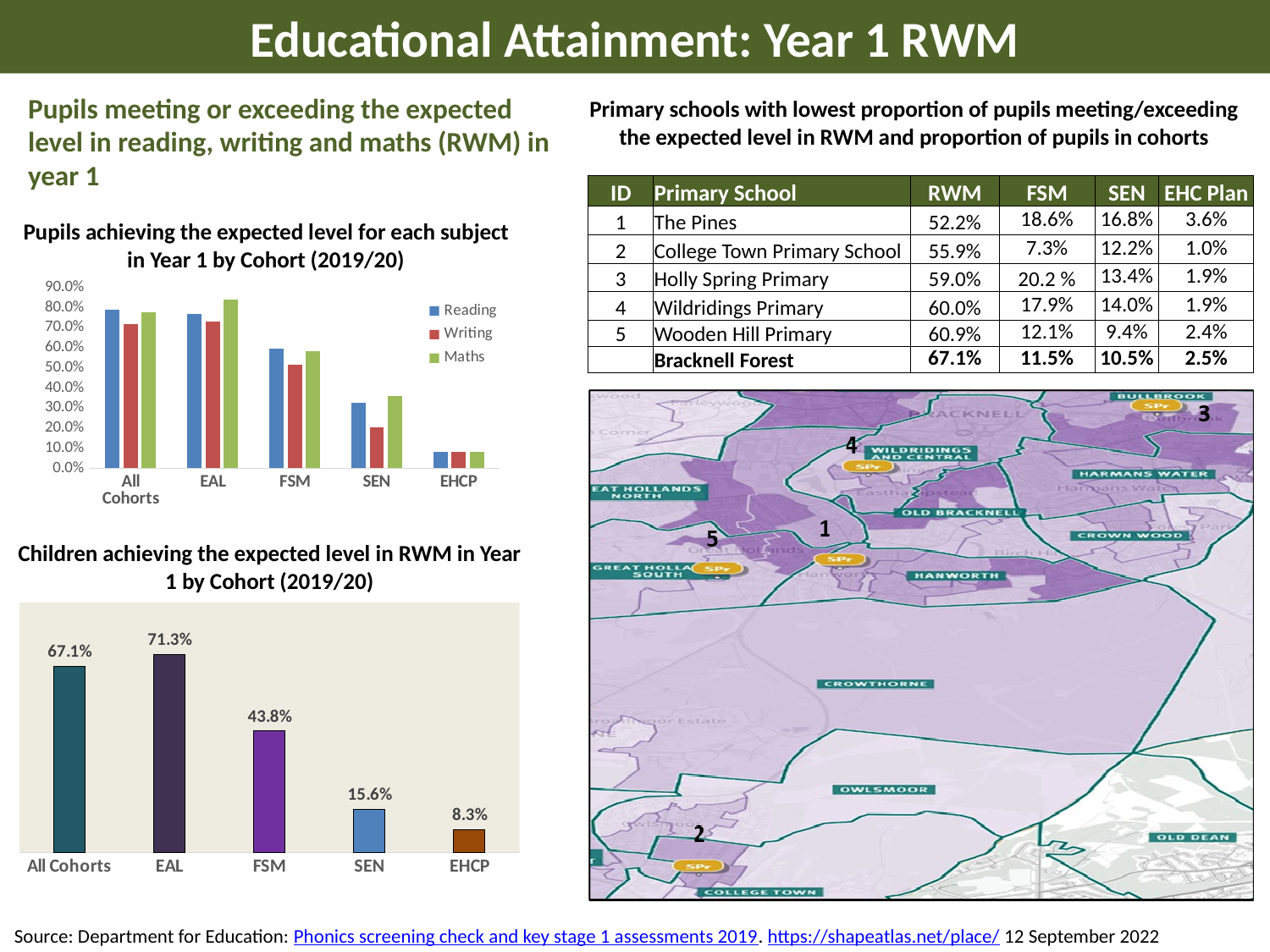
In the chart 'Children achieving the expected level in RWM in Year 1 by Cohort (2019/20)', which cohort has the highest value? EAL In the chart 'Children achieving the expected level in RWM in Year 1 by Cohort (2019/20)', which cohort has the lowest value? EHCP In the chart 'Children achieving the expected level in RWM in Year 1 by Cohort (2019/20)', what is the value for All Cohorts? 67.1% In the chart 'Pupils achieving the expected level for each subject in Year 1 by Cohort (2019/20)', is the Maths value for SEN greater or less than 30.0%? greater In the chart 'Children achieving the expected level in RWM in Year 1 by Cohort (2019/20)', what is the value for EAL? 71.3% In the chart 'Pupils achieving the expected level for each subject in Year 1 by Cohort (2019/20)', how many series does the legend list? 3 In the chart 'Pupils achieving the expected level for each subject in Year 1 by Cohort (2019/20)', which series is shown in green in the legend? Maths In the chart 'Children achieving the expected level in RWM in Year 1 by Cohort (2019/20)', how many cohorts are shown? 5 In the chart 'Children achieving the expected level in RWM in Year 1 by Cohort (2019/20)', what is the value for FSM? 43.8% In the chart 'Pupils achieving the expected level for each subject in Year 1 by Cohort (2019/20)', which is larger for the EAL cohort, Maths or Writing? Maths In the chart 'Children achieving the expected level in RWM in Year 1 by Cohort (2019/20)', what is the difference between the SEN and EHCP values? 7.3% What kind of chart is 'Pupils achieving the expected level for each subject in Year 1 by Cohort (2019/20)'? Bar chart